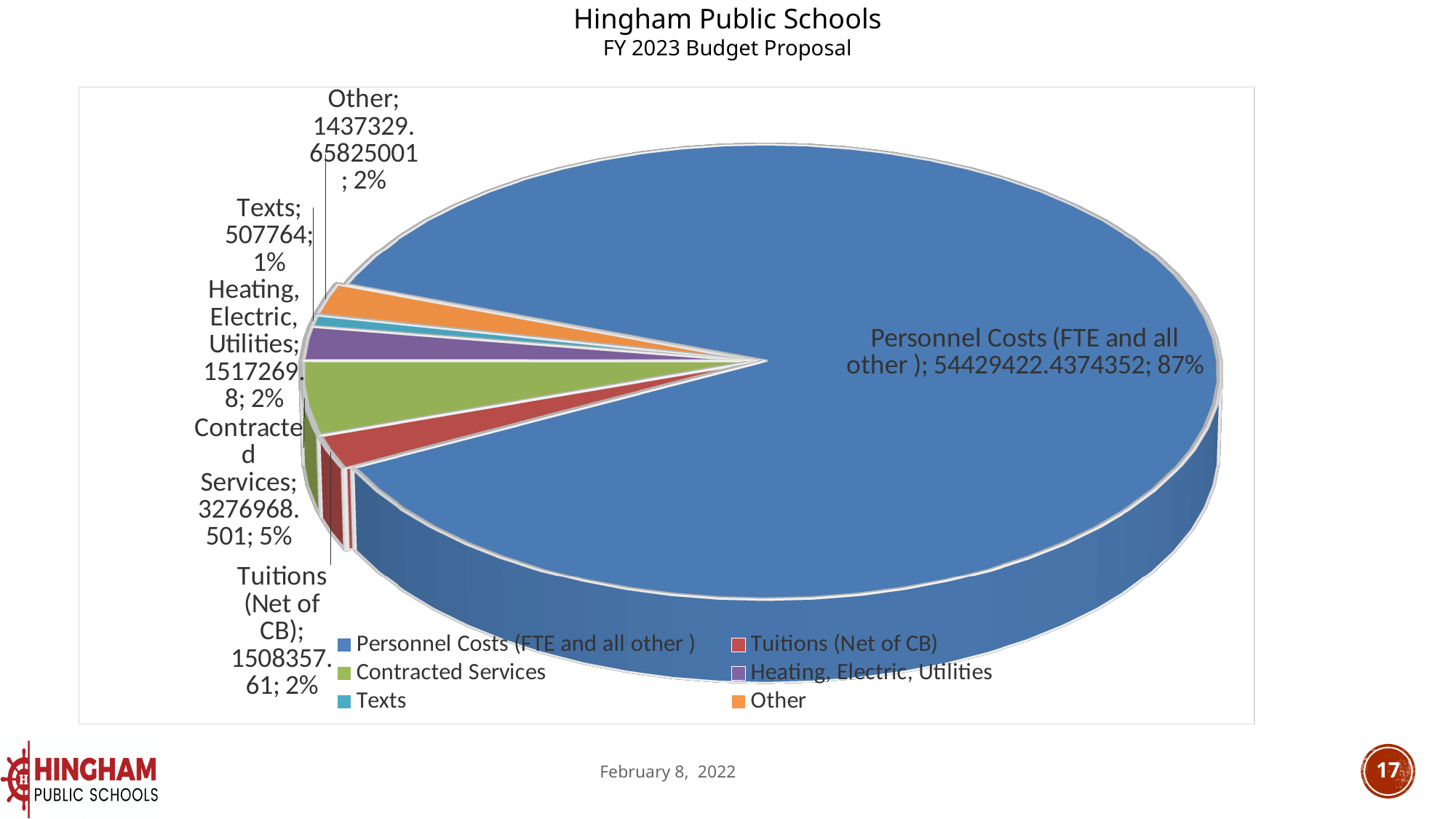
What share of the pie does Personnel Costs (FTE and all other) represent? 87% What is the value for Texts? 507764 What is the value for Contracted Services? 3276968.501 Which category has the largest slice of the pie? Personnel Costs (FTE and all other ) What kind of chart is shown on the slide? pie chart Which category has the smallest slice of the pie? Texts How many categories does the legend list? 6 Which is larger, Contracted Services or Texts? Contracted Services What is the value for Tuitions (Net of CB)? 1508357.61 What share of the pie does Contracted Services represent? 5% What is the difference between the values for Contracted Services and Texts? 2769204.501 What is the value for Heating, Electric, Utilities? 1517269.8